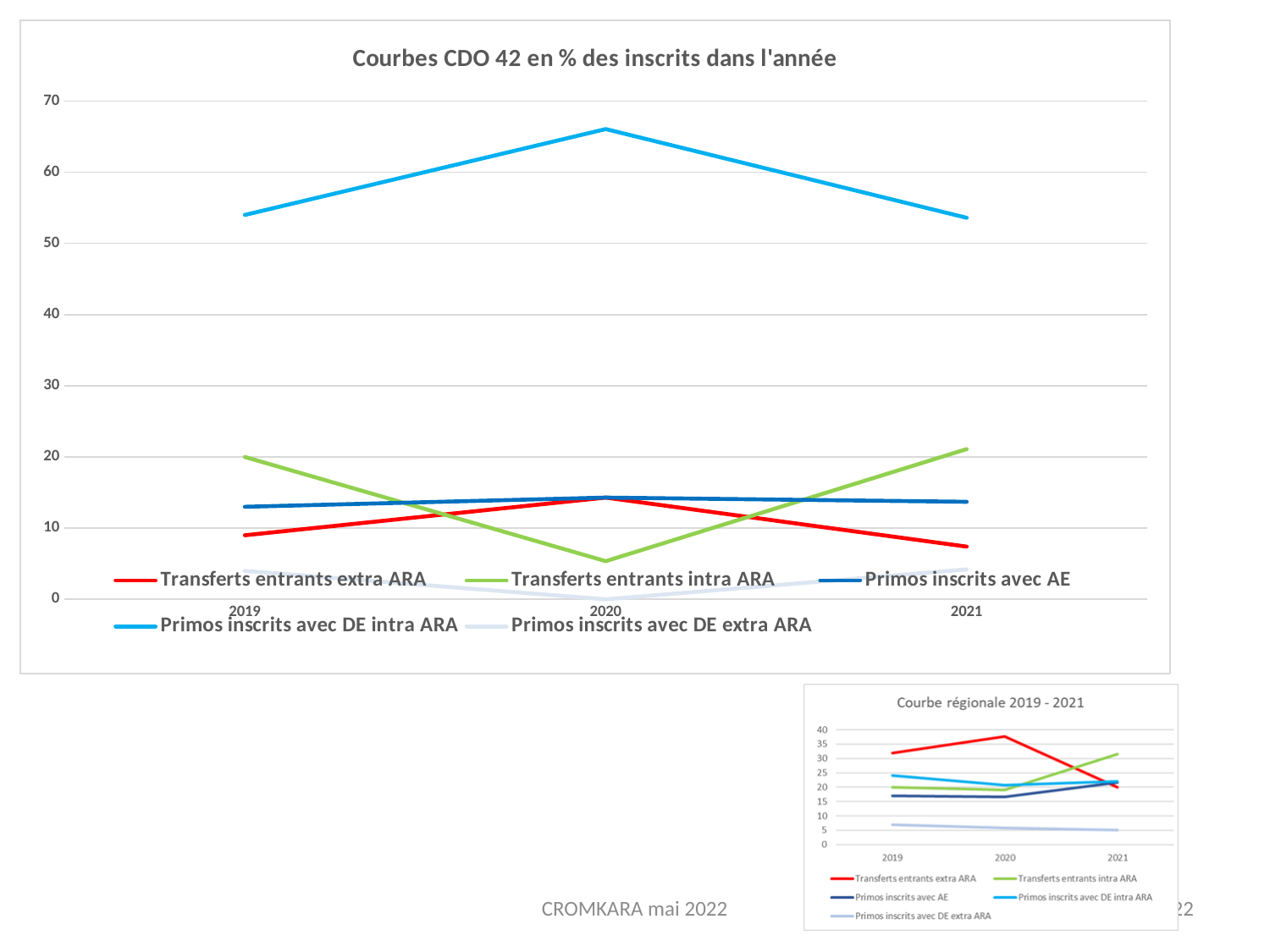
What kind of chart is the 'Courbes CDO 42 en % des inscrits dans l'année' chart? line chart How many series does the legend of the 'Courbe régionale 2019 - 2021' chart list? 5 In the 'Courbes CDO 42 en % des inscrits dans l'année' chart, which series has the lowest value in 2019? Primos inscrits avec DE extra ARA In the 'Courbes CDO 42 en % des inscrits dans l'année' chart, which series has the highest value in 2020? Primos inscrits avec DE intra ARA In the 'Courbes CDO 42 en % des inscrits dans l'année' chart, is the value for Primos inscrits avec DE intra ARA in 2020 greater or less than 60? greater In the 'Courbe régionale 2019 - 2021' chart, which series has the highest value in 2020? Transferts entrants extra ARA In the 'Courbes CDO 42 en % des inscrits dans l'année' chart, which is larger in 2021: Transferts entrants intra ARA or Transferts entrants extra ARA? Transferts entrants intra ARA In the 'Courbes CDO 42 en % des inscrits dans l'année' chart, is the value for Transferts entrants intra ARA in 2020 greater or less than 10? less How many series does the legend of the 'Courbes CDO 42 en % des inscrits dans l'année' chart list? 5 What is the title of the large chart at the top of the slide? Courbes CDO 42 en % des inscrits dans l'année How many years are shown on the x axis of the 'Courbes CDO 42 en % des inscrits dans l'année' chart? 3 In the 'Courbes CDO 42 en % des inscrits dans l'année' chart, does the Transferts entrants intra ARA line rise or fall from 2019 to 2020? fall